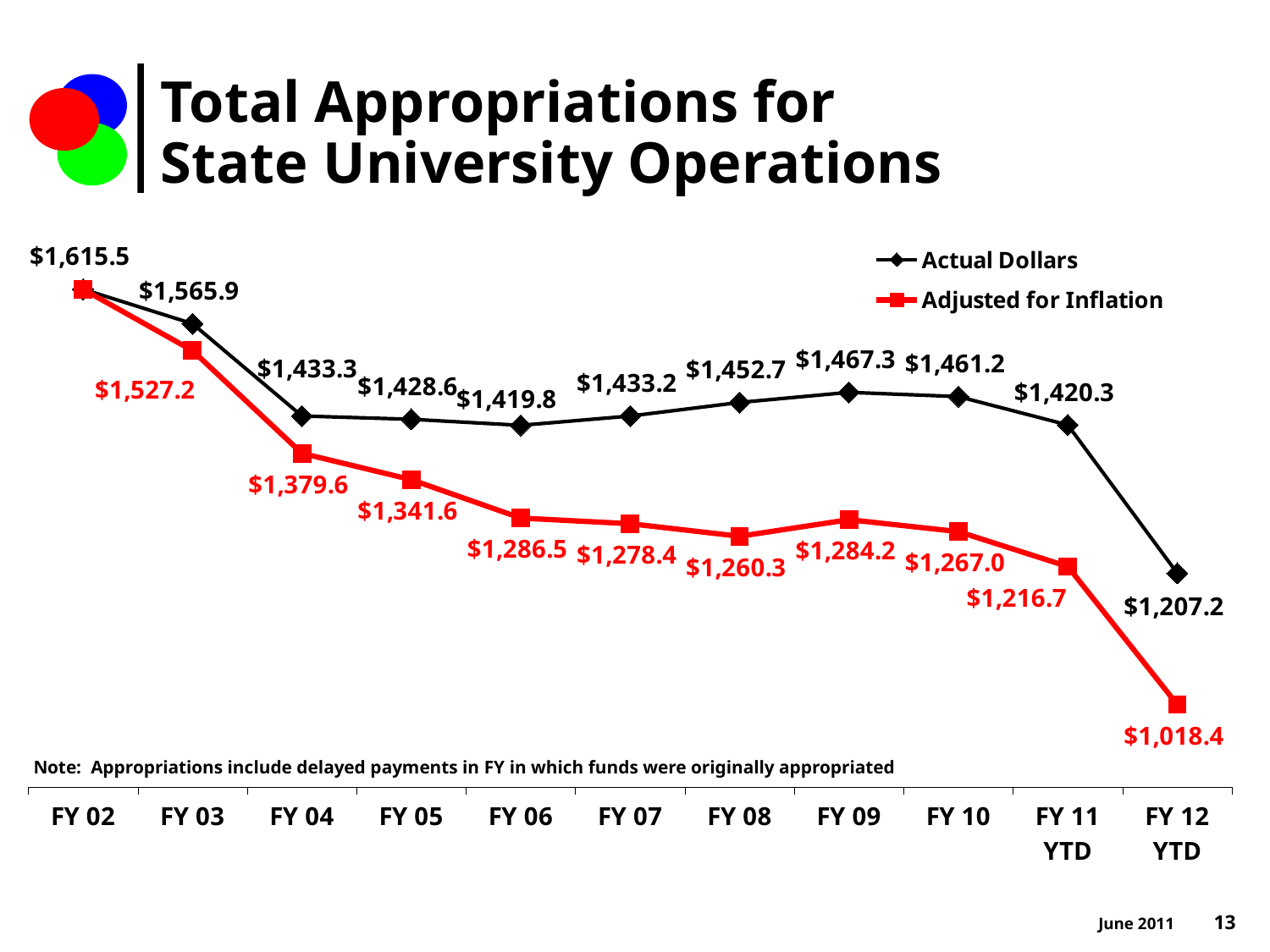
What is the difference between the Actual Dollars and Adjusted for Inflation values for FY 12 YTD? $188.8 In which fiscal year is the Actual Dollars series highest? FY 02 What is the difference between the Actual Dollars and Adjusted for Inflation values for FY 03? $38.7 Does the Adjusted for Inflation series rise or fall from FY 02 to FY 12 YTD? Fall What is the Adjusted for Inflation value for FY 06? $1,286.5 How many fiscal years are shown on the x axis? 11 Which is larger for Actual Dollars: FY 08 or FY 10? FY 10 In which fiscal year is the Adjusted for Inflation series lowest? FY 12 YTD What is the Actual Dollars value for FY 11 YTD? $1,420.3 What is the Actual Dollars value for FY 09? $1,467.3 What kind of chart is shown on the slide? Line chart How many series does the legend list? 2